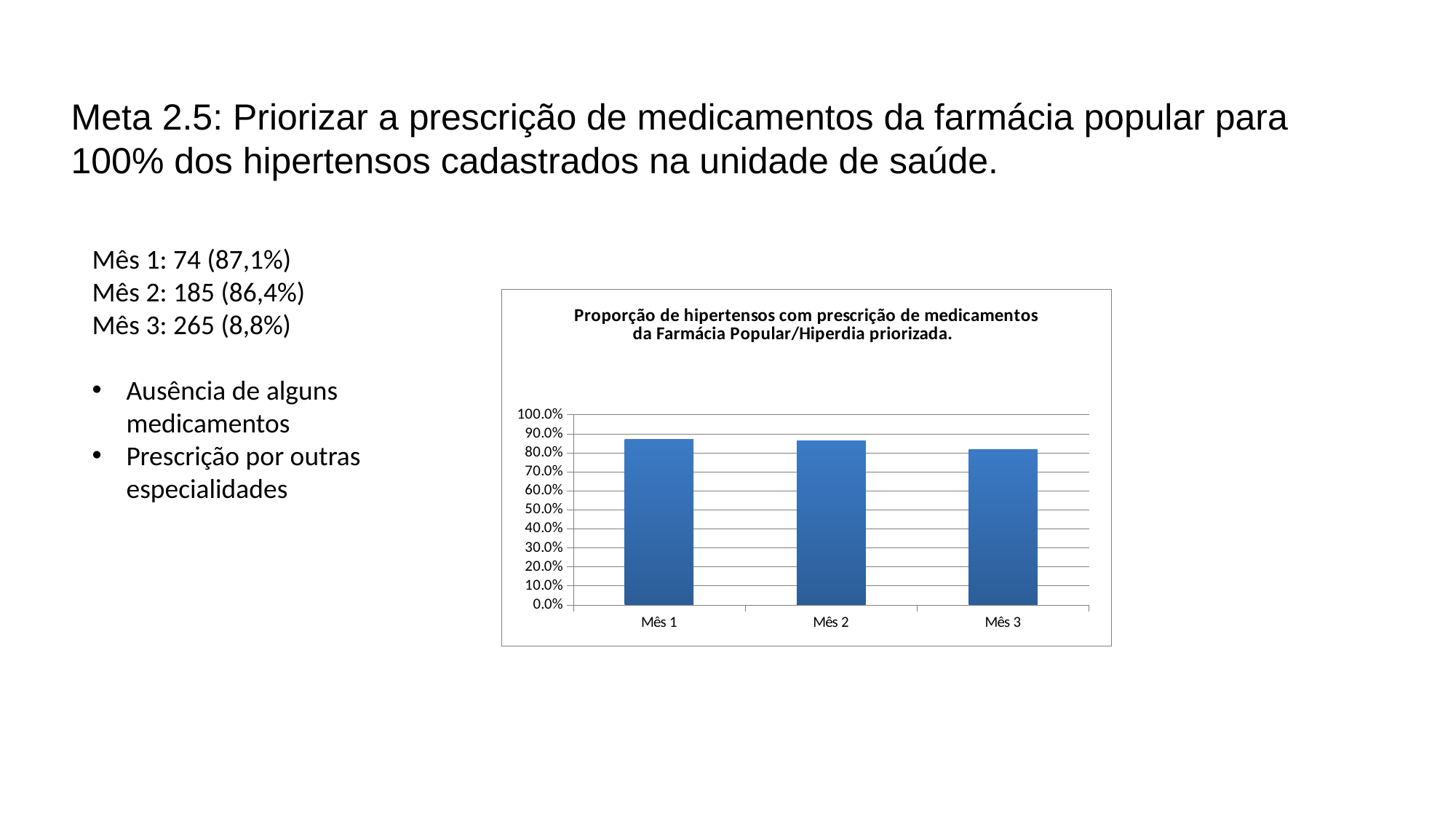
Which is larger on the chart, the value for Mês 1 or the value for Mês 3? Mês 1 What is the title of the chart? Proporção de hipertensos com prescrição de medicamentos da Farmácia Popular/Hiperdia priorizada. What is the highest value shown on the chart's vertical axis? 100.0% Is the value for Mês 2 greater or less than 50.0%? greater Which month has the lowest bar on the chart? Mês 3 What kind of chart is shown on the slide? bar chart Is the value for Mês 3 greater or less than 90.0%? less How many categories (months) are plotted on the chart? 3 Is the value for Mês 2 greater or less than 100.0%? less Do the bar values rise or fall from Mês 1 to Mês 3? fall